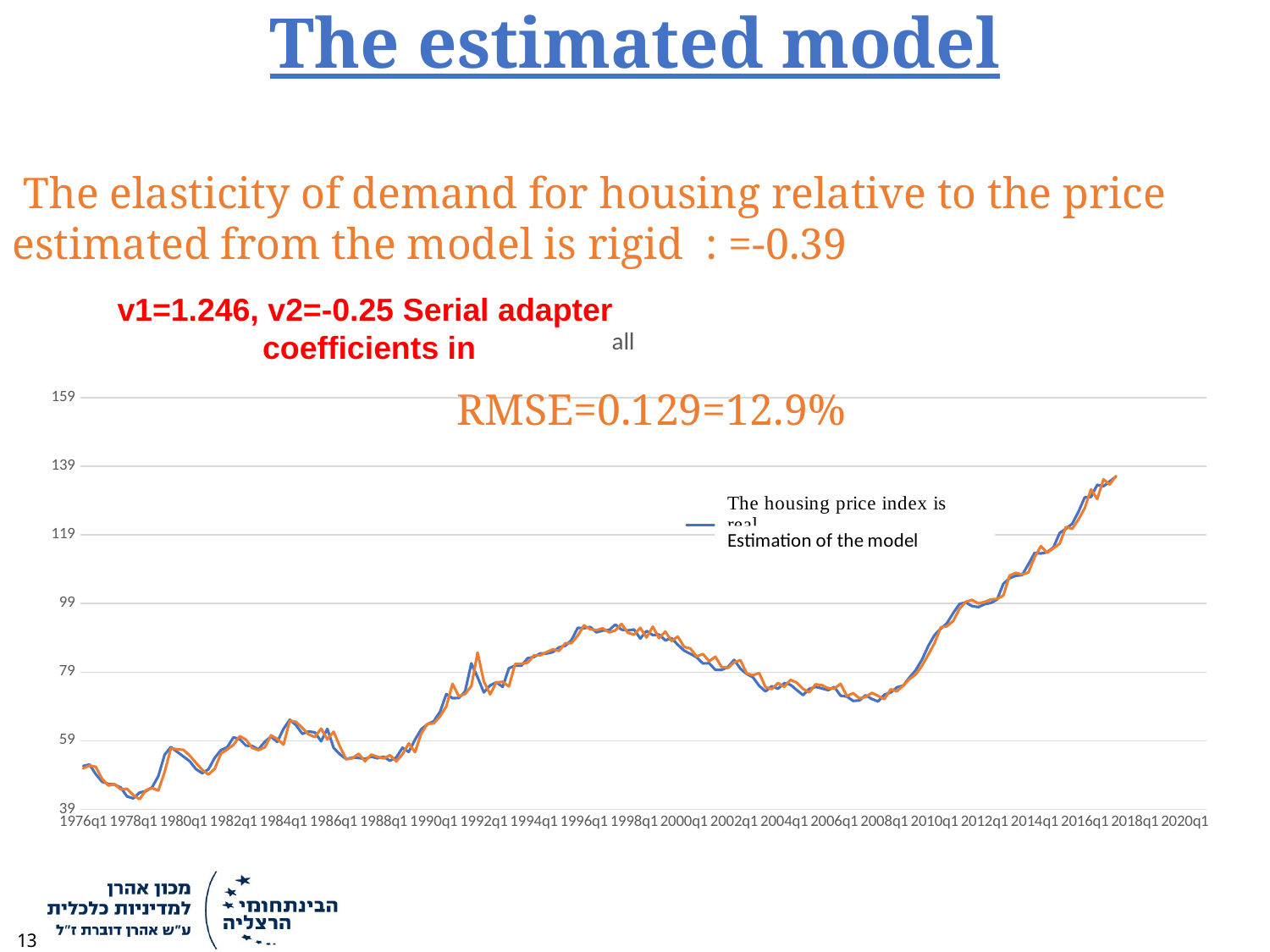
What kind of chart is shown on the slide? line chart What is the lowest value shown on the chart's vertical axis? 39 What is the second legend entry in the chart? Estimation of the model Do the plotted values rise or fall between 2008q1 and 2018q1? rise How many labelled tick marks are on the chart's horizontal axis? 23 Is the value of the housing price index around 2018q1 greater or less than 119? greater Is the value of the housing price index around 1996q1 greater or less than 79? greater Is the value of the housing price index around 2014q1 greater or less than 99? greater How many series does the chart's legend list? 2 Do the plotted values rise or fall between 1996q1 and 2004q1? fall